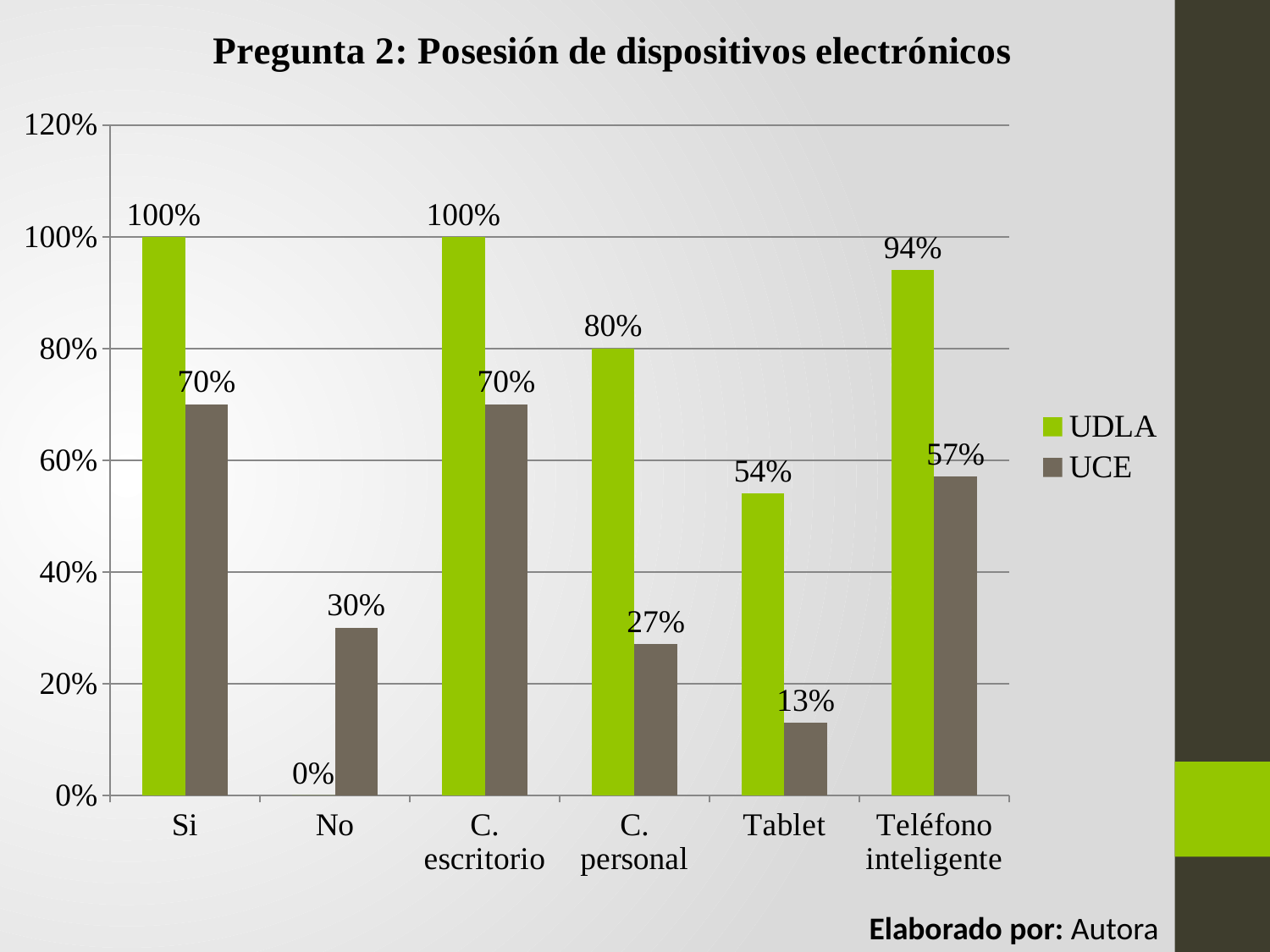
What kind of chart is shown on the slide? Bar chart What is the difference between the UDLA and UCE values for Tablet? 41% How many series does the legend list? 2 What is the difference between the UDLA and UCE values for C. escritorio? 30% What is the UDLA value for Teléfono inteligente? 94% Which category has the lowest UCE value? Tablet Which category has the lowest UCE value among those with a non-zero UCE bar? Tablet What is the UCE value for C. personal? 27% What is the UCE value for No? 30% How many categories are shown on the x axis? 6 What is the UDLA value for Tablet? 54% Which is larger for Teléfono inteligente, the UDLA value or the UCE value? UDLA